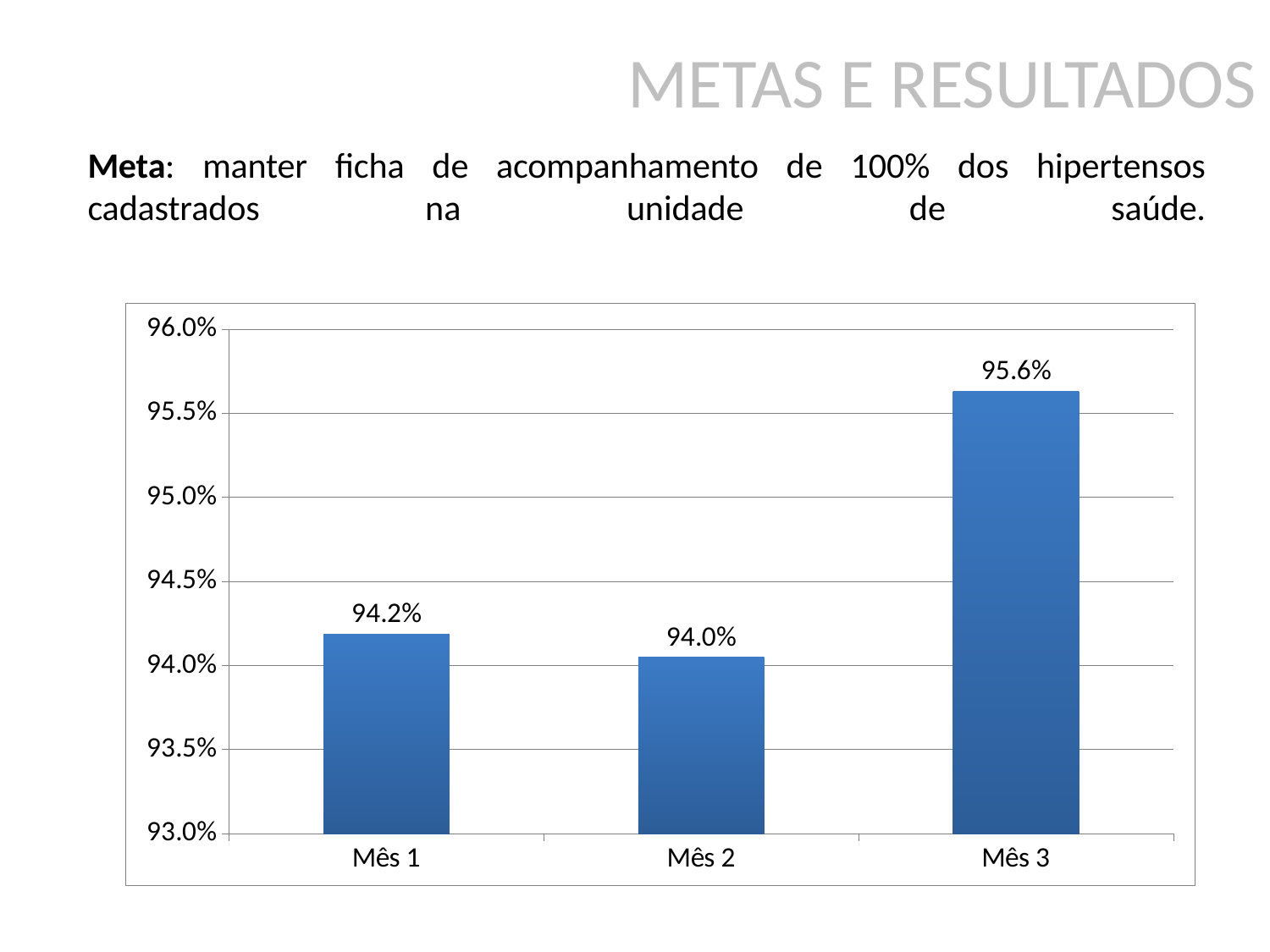
Which is larger, the value for Mês 1 or the value for Mês 3? Mês 3 What is the difference between the values for Mês 3 and Mês 1? 1.4% What is the difference between the values for Mês 1 and Mês 2? 0.2% What kind of chart is shown on the slide? Bar chart What is the value for Mês 2? 94.0% What is the value for Mês 3? 95.6% Is the value for Mês 2 greater or less than 94.5%? less What is the value for Mês 1? 94.2% Which month has the lowest value? Mês 2 How many categories are shown on the x axis? 3 Which month has the highest value? Mês 3 Is the value for Mês 3 greater or less than 95.0%? greater